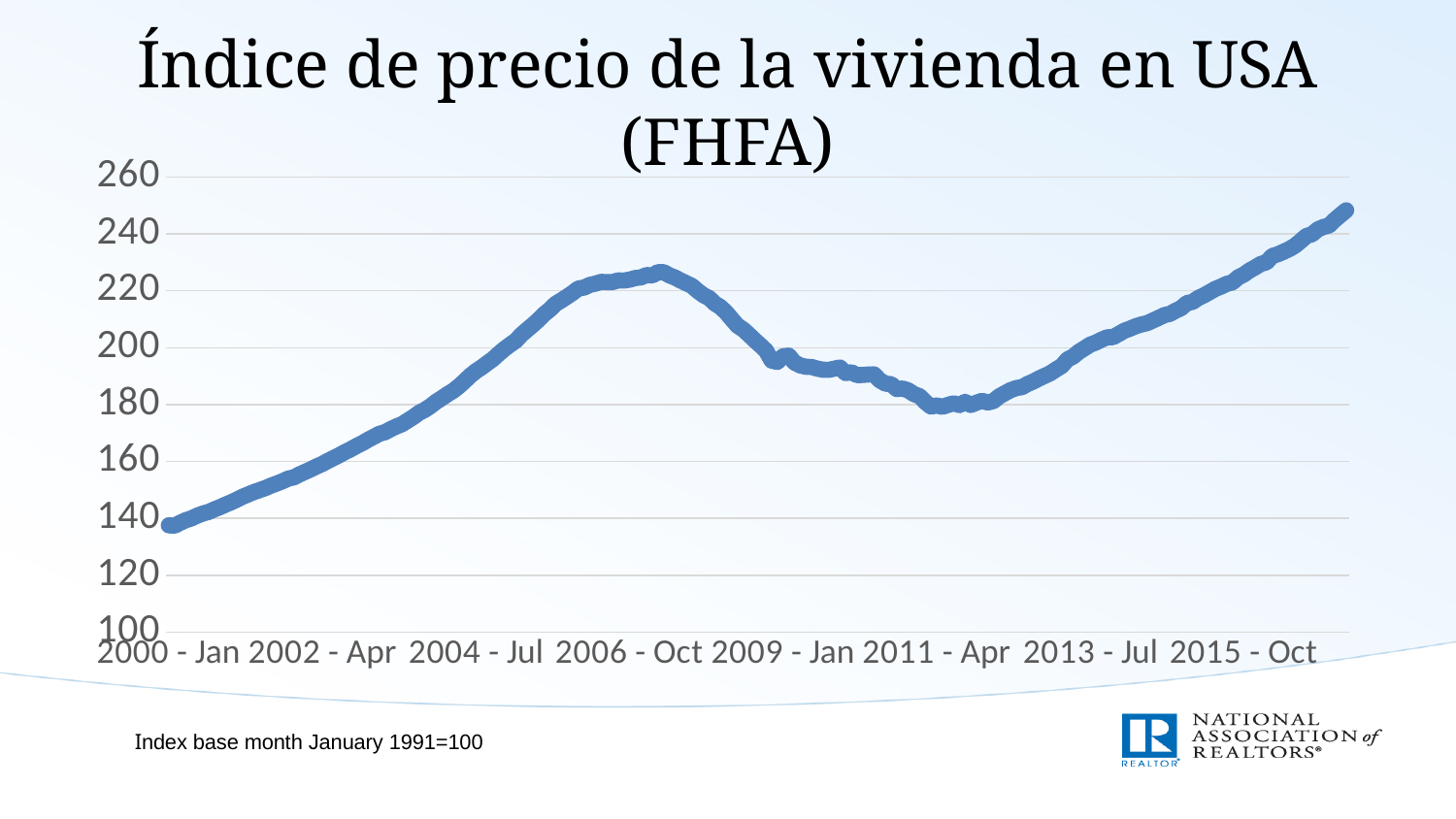
Is the value at 2011 - Apr greater or less than 200? less Is the value at 2000 - Jan greater or less than 160? less Does the index rise or fall between 2000 - Jan and 2006 - Oct? rise What is the index base month and value stated on the slide? January 1991=100 How many date labels are shown on the x axis? 8 Is the value at 2015 - Oct greater or less than 220? greater What kind of chart is shown on the slide? line chart What is the title of the chart? Índice de precio de la vivienda en USA (FHFA) Does the index rise or fall between 2006 - Oct and 2011 - Apr? fall